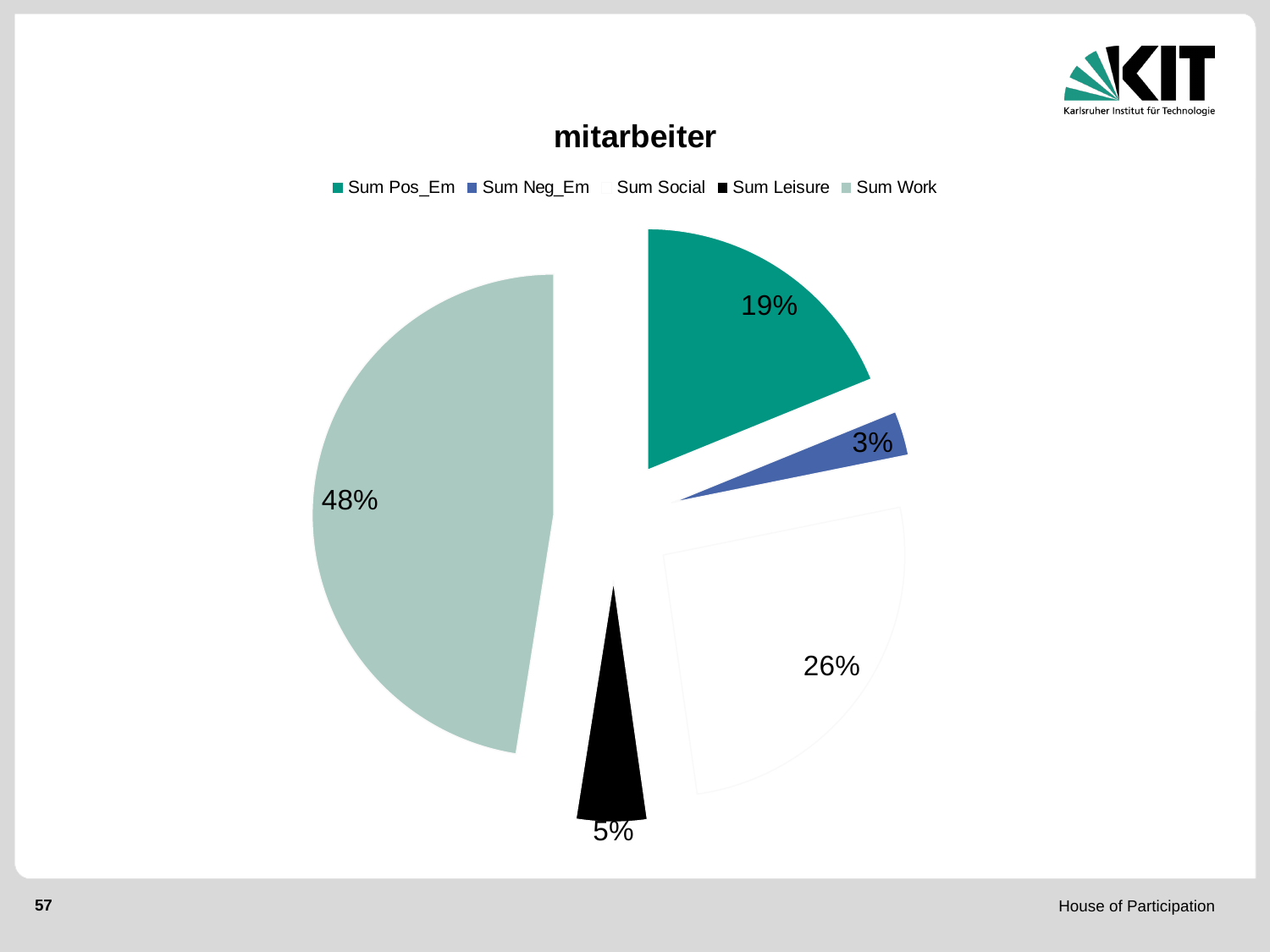
What share of the pie is Sum Social? 26% What kind of chart is shown on the slide? pie chart How many series does the legend list? 5 What share of the pie is Sum Neg_Em? 3% How many slices does the pie chart have? 5 What share of the pie is Sum Pos_Em? 19% Which category has the smallest share of the pie? Sum Neg_Em Which category has the largest share of the pie? Sum Work What is the title of the chart? mitarbeiter What is the difference in percentage points between Sum Work and Sum Social? 22